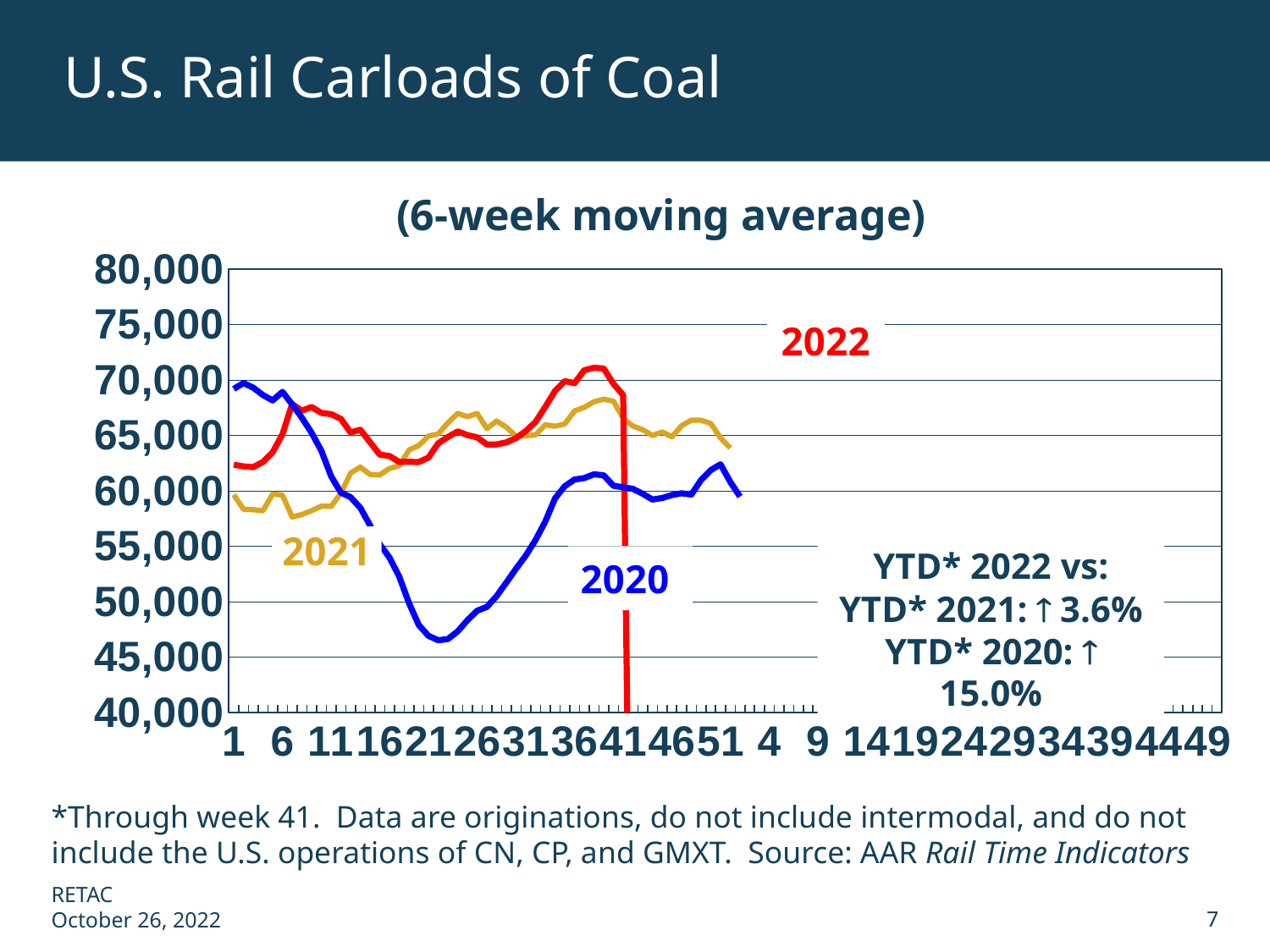
What kind of chart is shown on the slide? line chart At week 1, which is higher: the 2020 line or the 2021 line? 2020 Which series reaches the lowest point on the chart? 2020 Is the highest point of the 2022 line greater or less than 70,000? greater Is the value for 2022 at week 1 greater or less than 60,000? greater Is the lowest point of the 2020 line greater or less than 50,000? less According to the annotation, by what percentage is YTD 2022 up versus YTD 2021? 3.6% Does the 2020 line rise or fall between week 1 and week 21? fall What colour is the line for 2022? red How many data series (years) are plotted on the chart? 3 What is the subtitle shown above the chart? (6-week moving average)